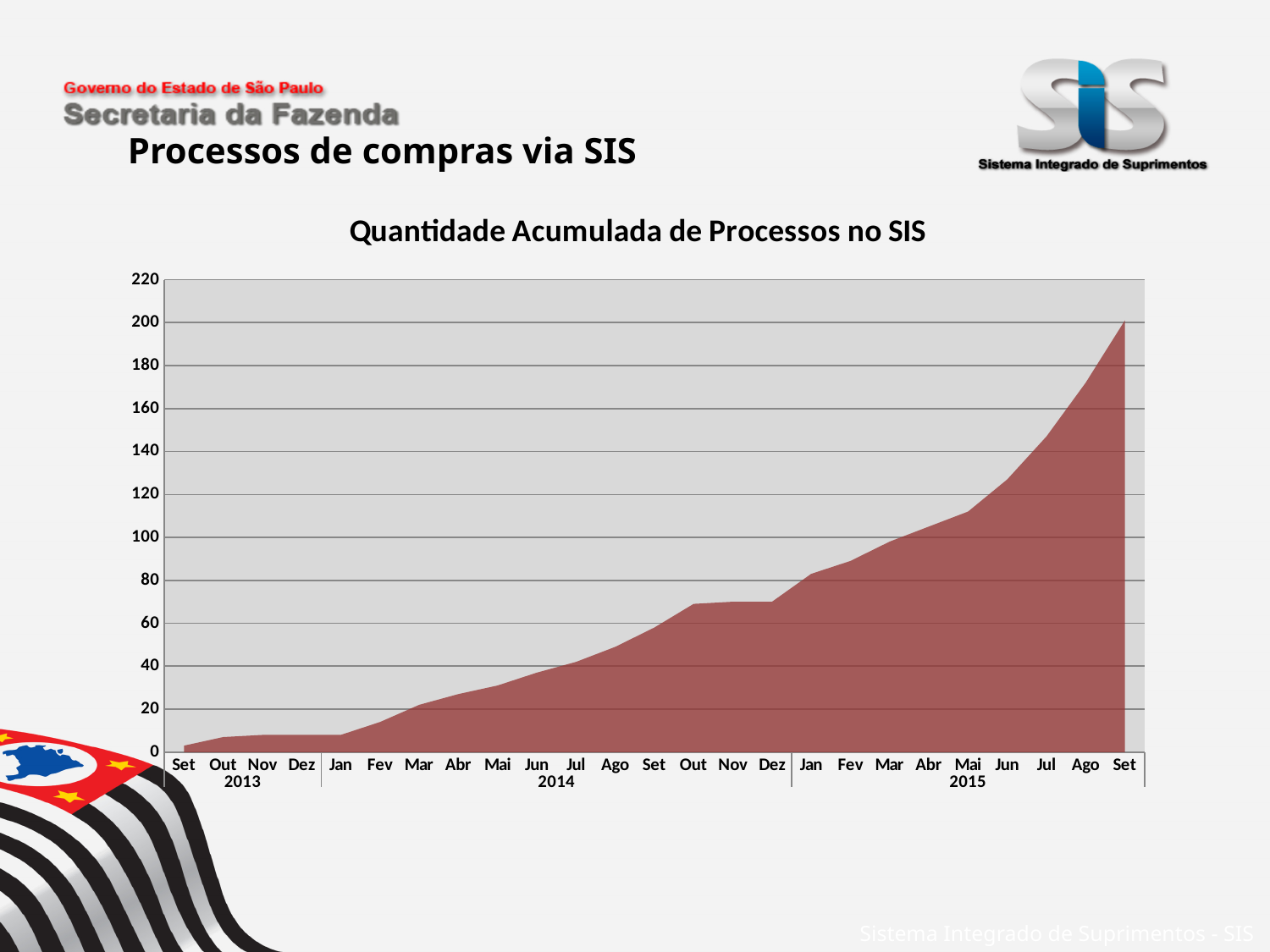
Do the values rise or fall along the x axis from Set 2013 to Set 2015? rise What kind of chart is shown on the slide? area chart Is the value for Dez 2014 greater or less than 80? less Is the value for Mai 2015 greater or less than 100? greater Is the value for Set 2015 greater or less than 180? greater How many months are plotted along the x axis? 25 Which is larger, the value for Jul 2014 or the value for Jul 2015? Jul 2015 Which month has the highest value in the chart? Set 2015 What is the title of the chart? Quantidade Acumulada de Processos no SIS Which month has the lowest value in the chart? Set 2013